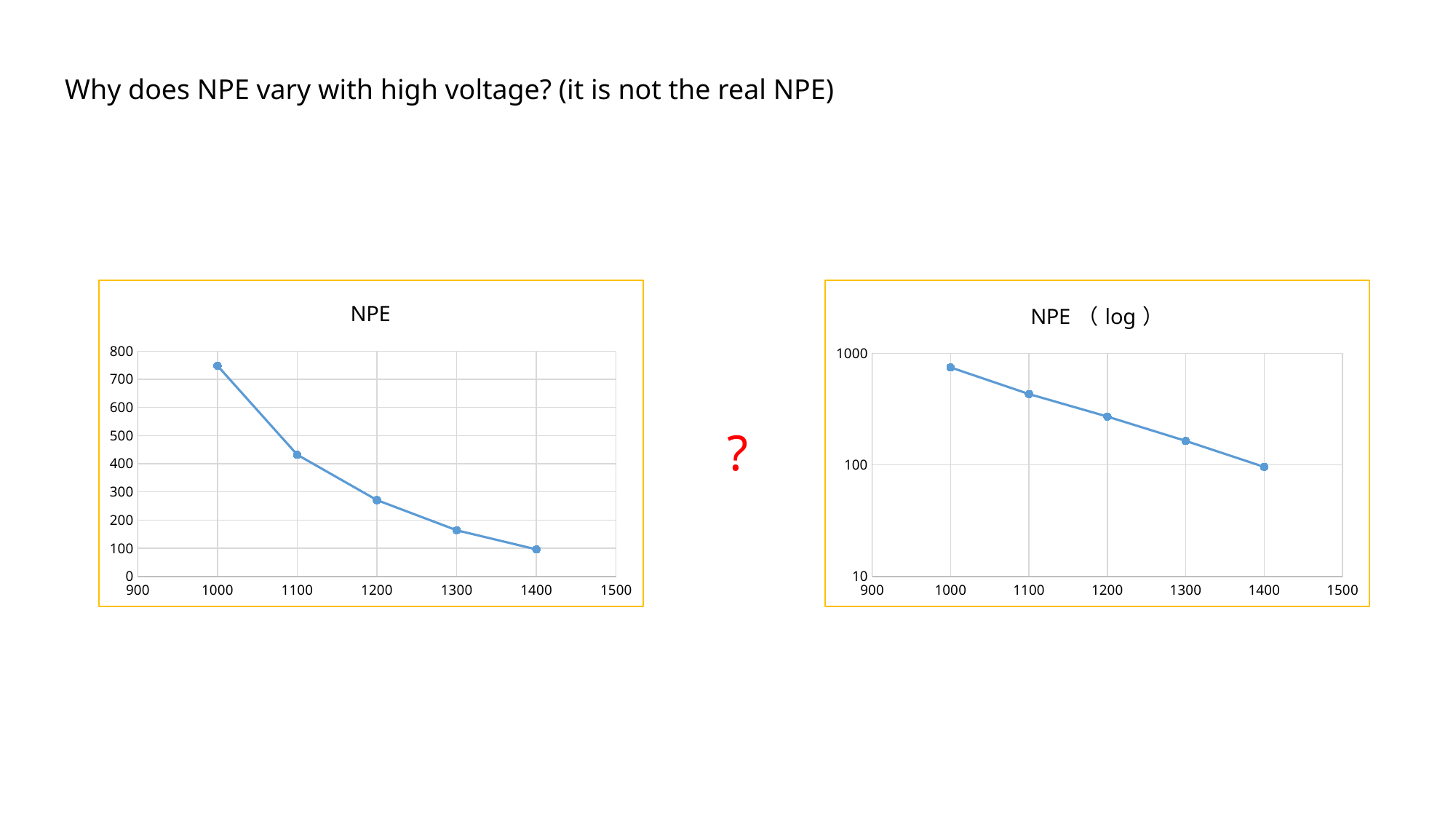
What kind of chart is the chart titled "NPE" on the left? line chart In the chart titled "NPE" on the left, at which x-axis value is NPE highest? 1000 What is the title of the chart on the right of the slide? NPE （ log ） In the chart titled "NPE" on the left, is the value at 1000 greater or less than 700? greater In the chart titled "NPE" on the left, is the value at 1300 greater or less than 200? less In the chart titled "NPE" on the left, is the value at 1200 greater or less than 300? less In the chart titled "NPE" on the left, which is larger, the value at 1100 or the value at 1300? the value at 1100 In the chart titled "NPE" on the left, at which x-axis value is NPE lowest? 1400 In the chart titled "NPE" on the left, how many data points are plotted? 5 In the chart titled "NPE" on the left, do the values rise or fall as the x-axis value increases from 1000 to 1400? fall